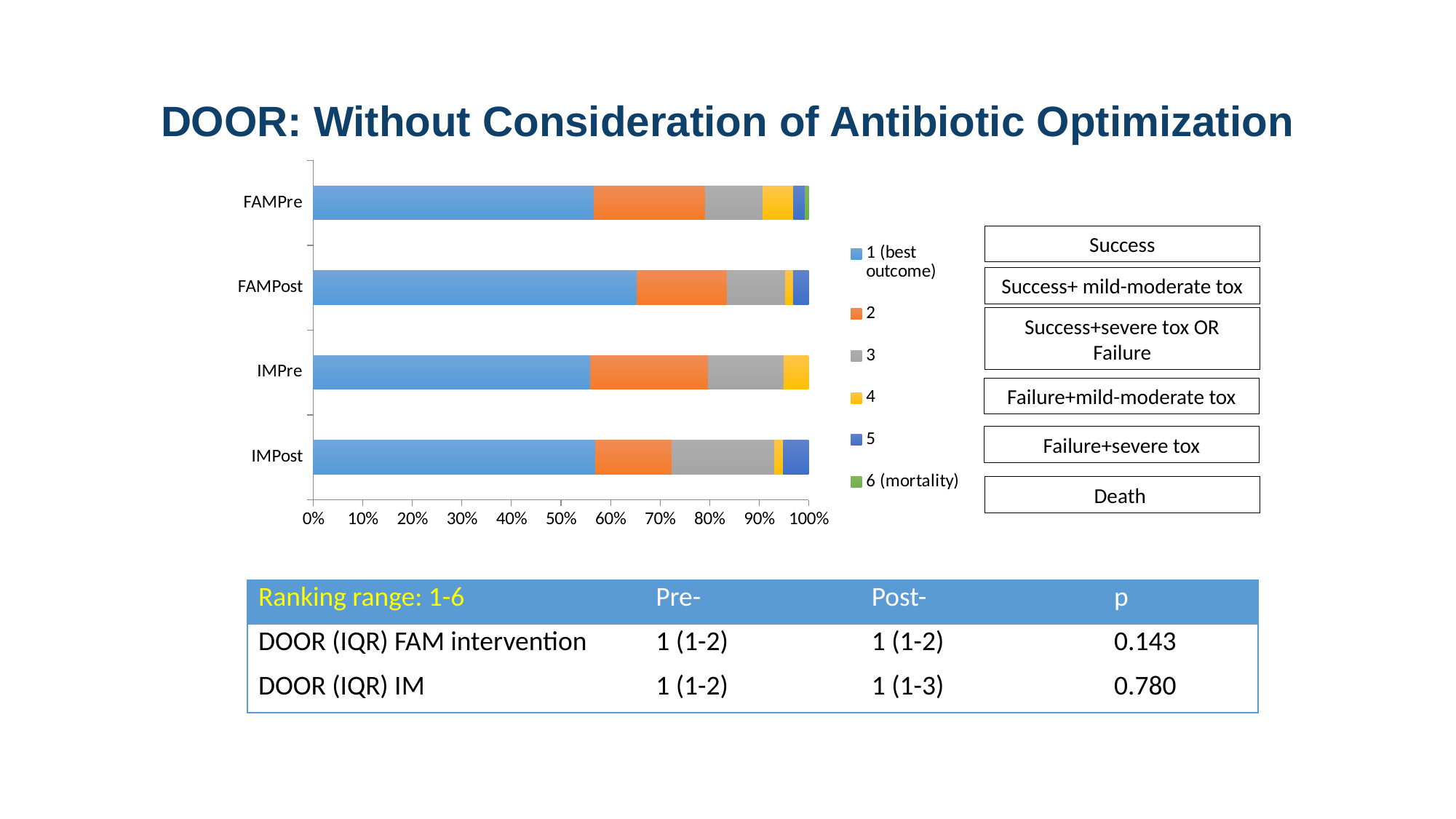
Which category has the largest segment for series 3? IMPost How many series does the chart legend list? 6 Which legend entry is shown in green? 6 (mortality) Is the share of series 1 (best outcome) for IMPost greater or less than 50%? greater Is the series 1 (best outcome) segment larger for FAMPost or for FAMPre? FAMPost What is the title of the slide containing the chart? DOOR: Without Consideration of Antibiotic Optimization How many categories (bars) does the chart show? 4 Which category has the largest segment for series 1 (best outcome)? FAMPost Is the share of series 1 (best outcome) for FAMPost greater or less than 60%? greater Which category is the only one with a visible segment for series 6 (mortality)? FAMPre Is the share of series 1 (best outcome) for FAMPre greater or less than 60%? less What kind of chart is shown on the slide? Stacked bar chart